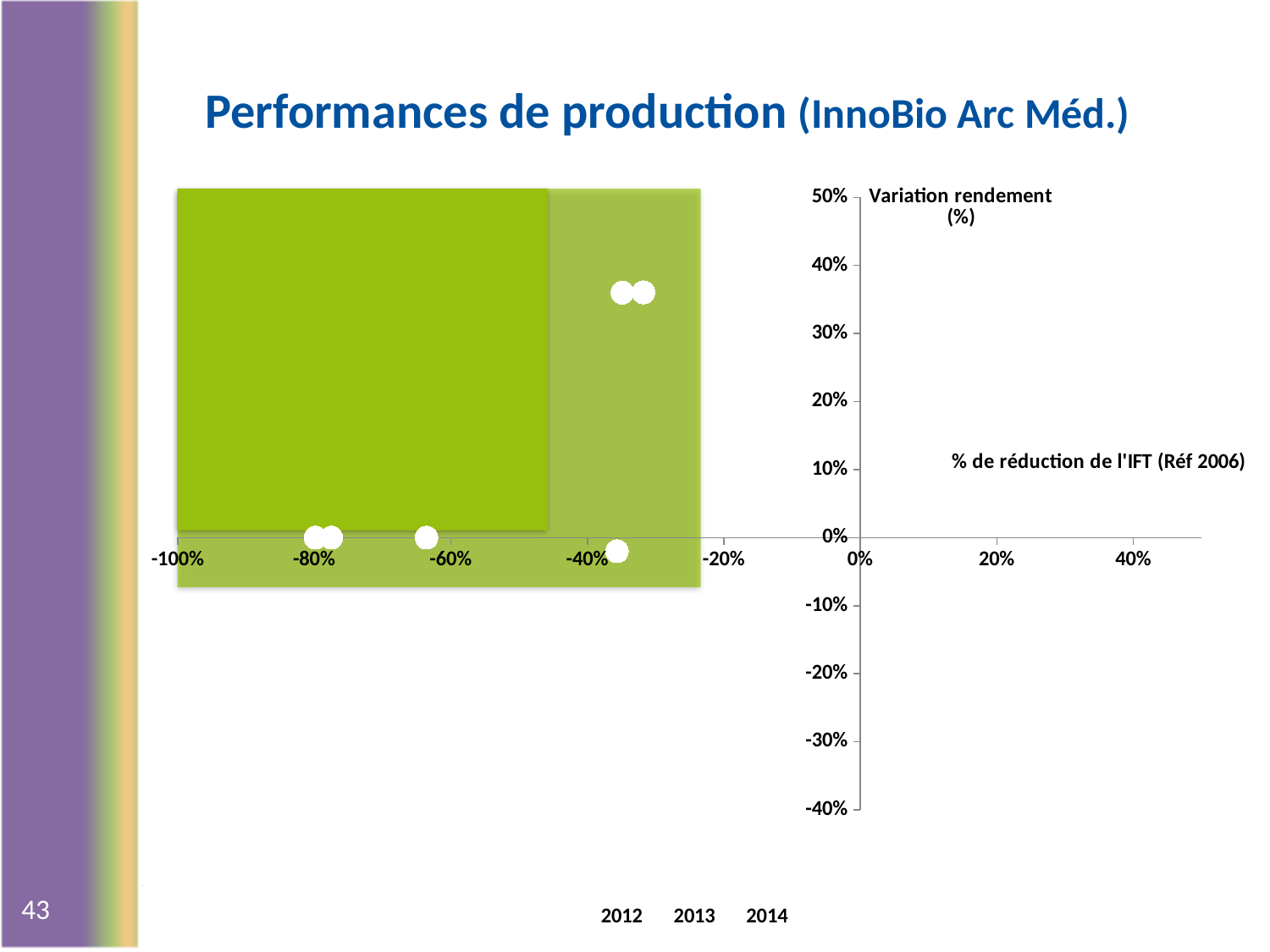
Are all plotted points located at an IFT reduction greater or less than 0%? less Is the IFT reduction of the leftmost plotted points greater or less than -60%? less Is the yield variation of the highest plotted points greater or less than 40%? less What kind of chart is shown on the slide? scatter chart How many series does the legend at the bottom of the chart list? 3 What is the title of the vertical axis of the chart? Variation rendement (%) What are the legend entries of the chart? 2012, 2013, 2014 How many data points are plotted on the chart? 6 What is the lowest value shown on the vertical axis of the chart? -40%